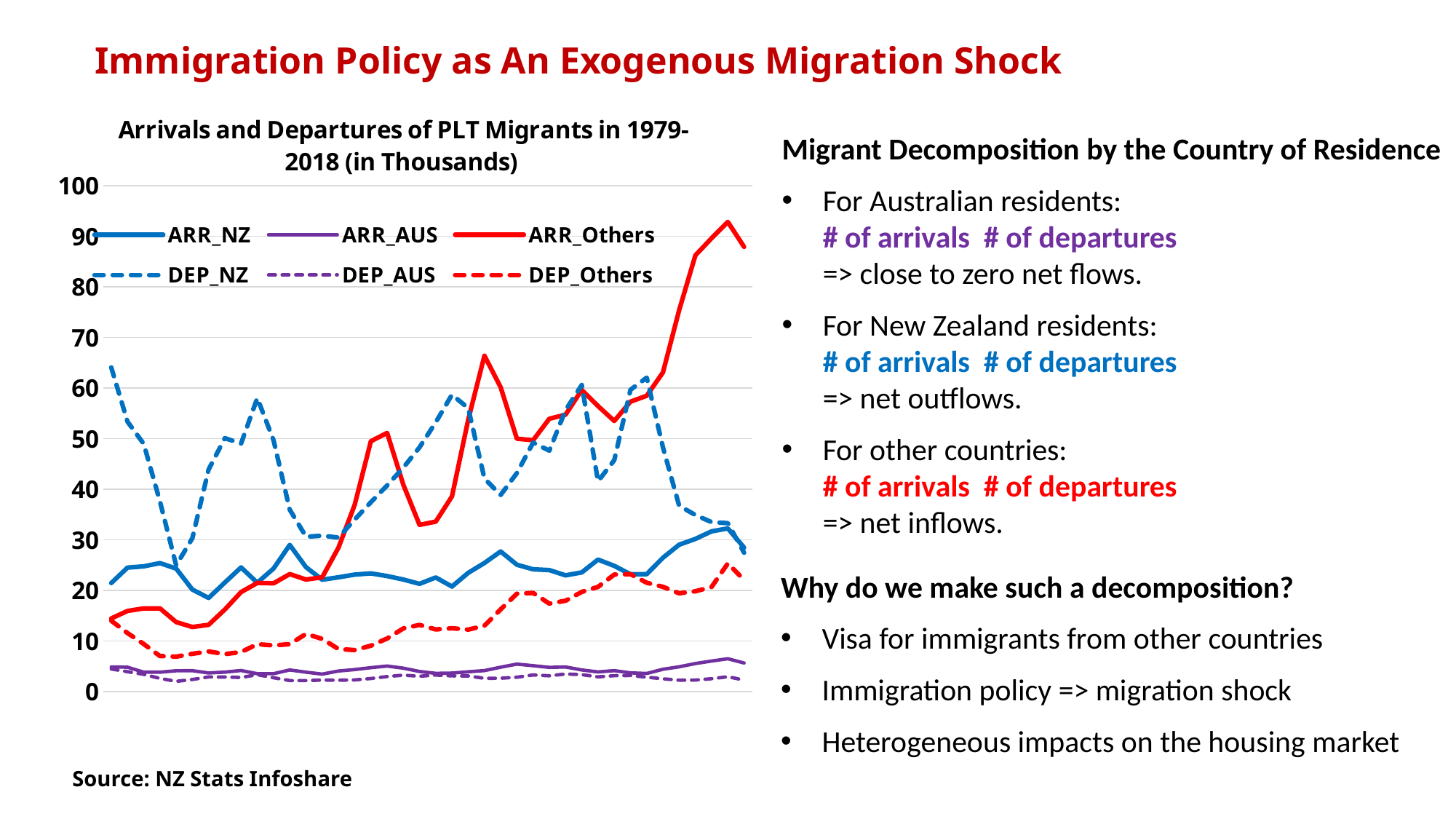
What kind of chart is shown on the slide? Line chart Is the highest value of ARR_AUS greater or less than 10? less What is the title of the chart? Arrivals and Departures of PLT Migrants in 1979-2018 (in Thousands) How many series does the chart legend list? 6 At the start of the period, which is larger: DEP_NZ or ARR_NZ? DEP_NZ Does the ARR_Others series rise or fall overall from the start to the end of the period? Rise Which series reaches the highest value on the chart? ARR_Others How are the departure series (DEP_NZ, DEP_AUS, DEP_Others) distinguished from the arrival series in the chart? They are drawn as dashed lines Is the first value of DEP_NZ greater or less than 60? greater Is the peak value of ARR_Others greater or less than 80? greater At the end of the period, which is larger: ARR_Others or DEP_Others? ARR_Others